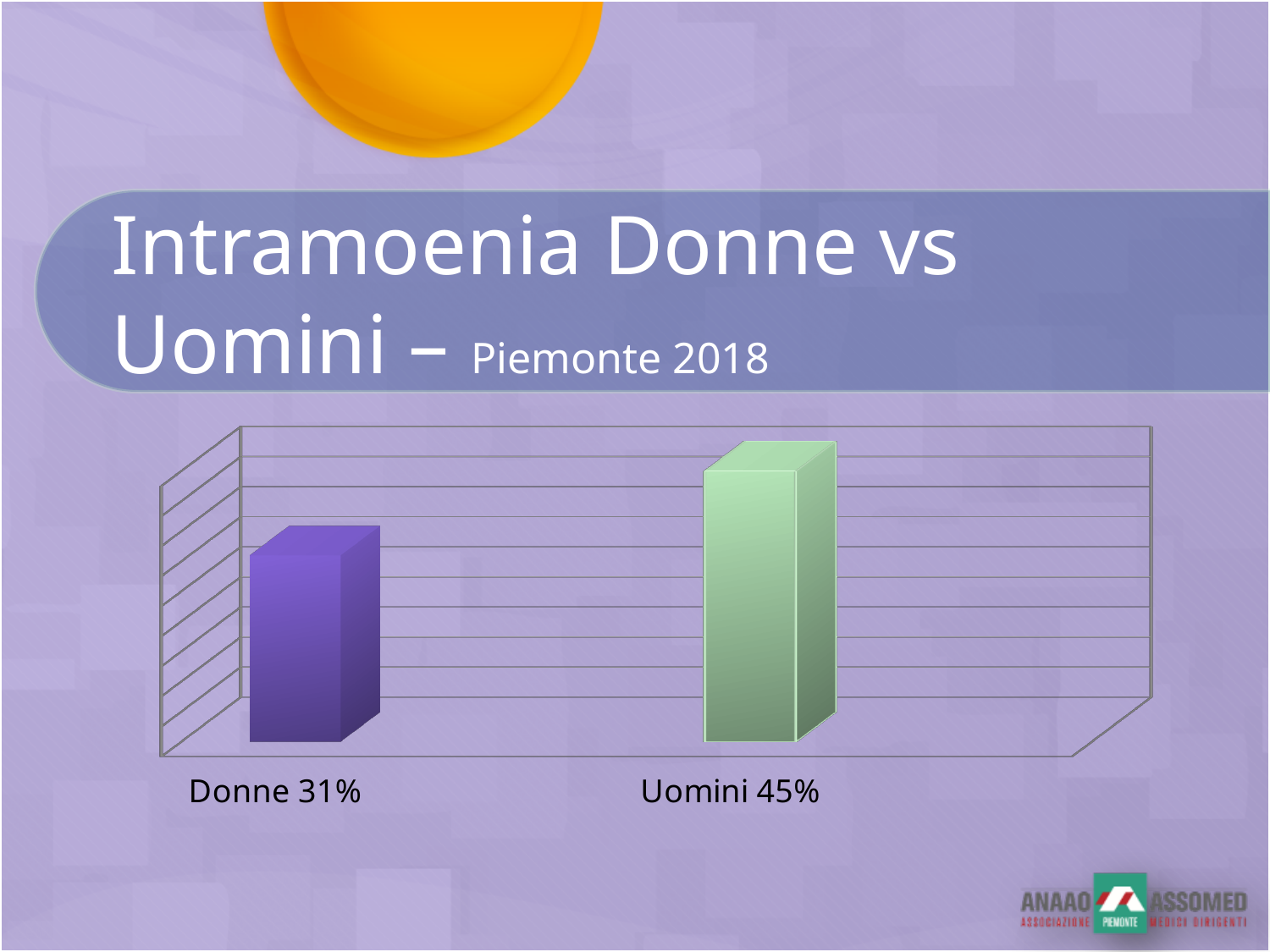
What colour is the bar for Donne? purple What is the value for Donne? 31% Which category has the lowest value? Donne Which is larger, the value for Donne or the value for Uomini? Uomini What is the value for Uomini? 45% What is the difference between the values for Uomini and Donne? 14% How many categories are shown in the chart? 2 Which category has the highest value? Uomini What is the title of the slide containing the chart? Intramoenia Donne vs Uomini – Piemonte 2018 What kind of chart is shown on the slide? bar chart